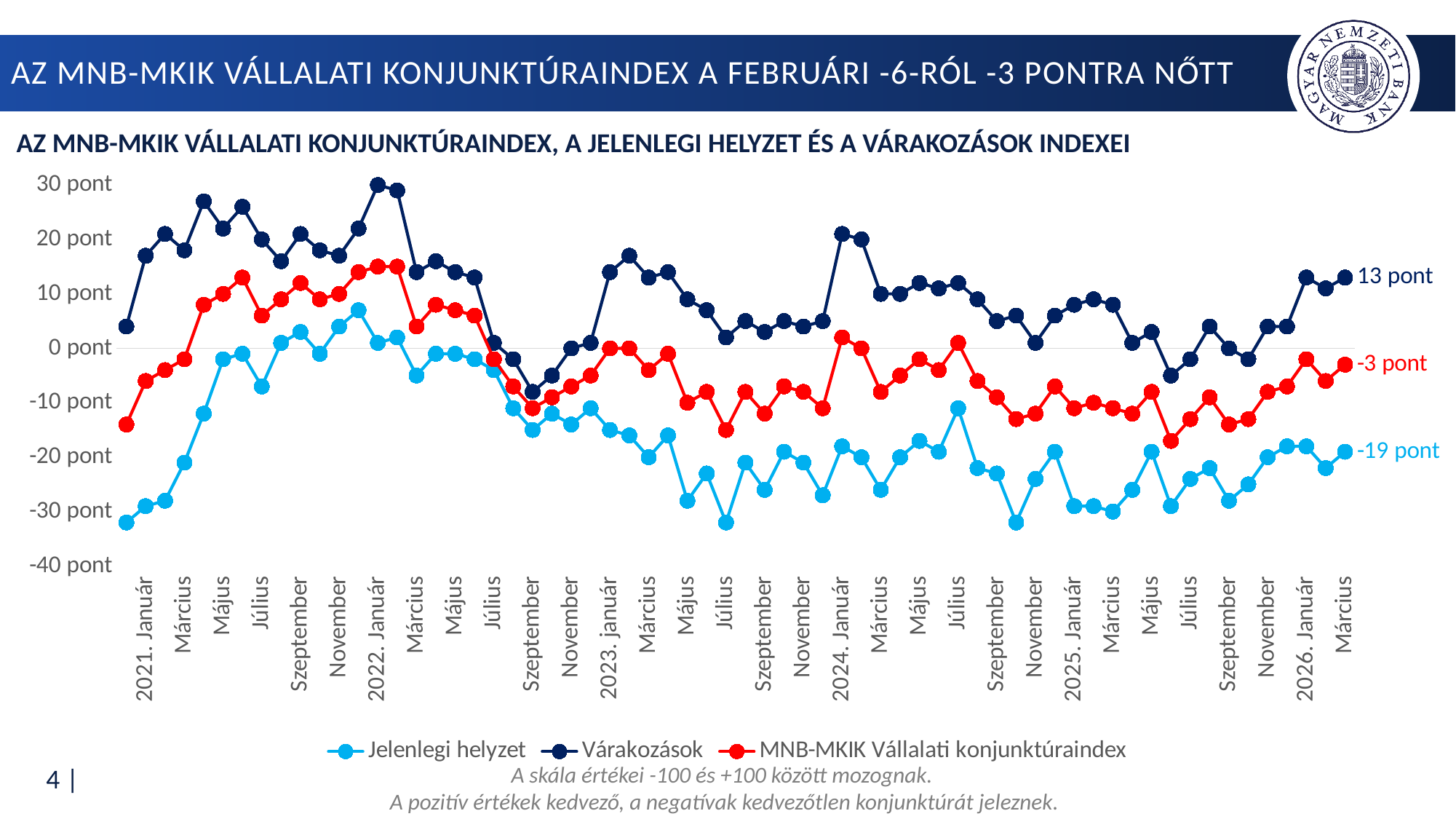
At the last point on the chart, which series has the highest value? Várakozások What is the difference between the latest labelled values of Várakozások (13 pont) and Jelenlegi helyzet (-19 pont)? 32 pont What is the latest value shown for the Jelenlegi helyzet series at the right end of the chart? -19 pont At the last point on the chart, which is larger: the Várakozások value or the Jelenlegi helyzet value? Várakozások How many series does the legend list? 3 What is the latest value shown for the Várakozások series at the right end of the chart? 13 pont What is the latest value shown for the MNB-MKIK Vállalati konjunktúraindex series at the right end of the chart? -3 pont At the last point on the chart, which series has the lowest value? Jelenlegi helyzet What kind of chart is shown on the slide? line chart What is the difference between the latest labelled values of Várakozások (13 pont) and the MNB-MKIK Vállalati konjunktúraindex (-3 pont)? 16 pont Is the value of Várakozások in 2022. Január greater or less than 20 pont? greater